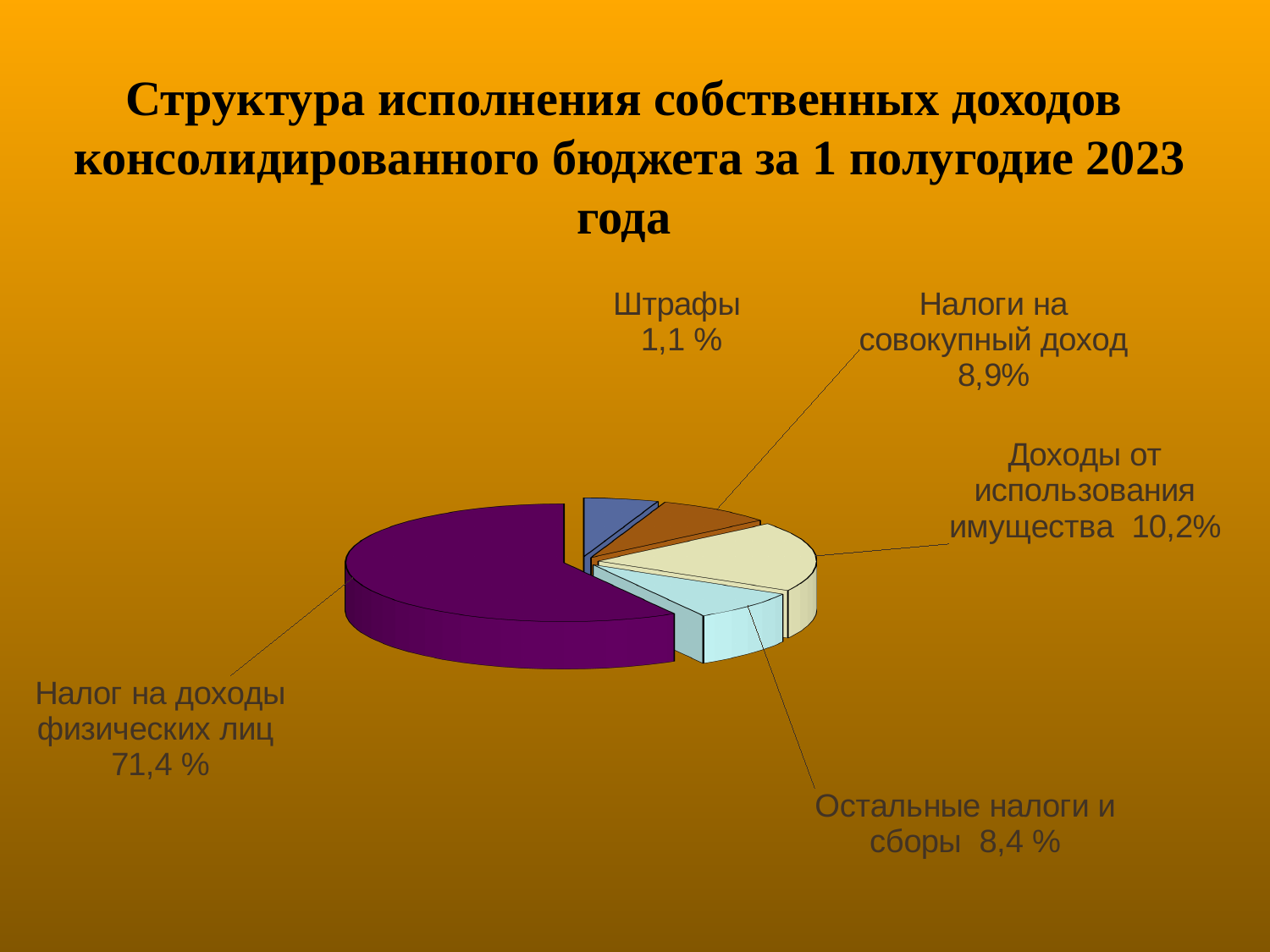
What value is shown for Налоги на совокупный доход? 8,9% How many slices does the pie chart have? 5 What is the title of the chart on the slide? Структура исполнения собственных доходов консолидированного бюджета за 1 полугодие 2023 года What share of the pie is labelled for Налог на доходы физических лиц? 71,4 % Which is larger: Налоги на совокупный доход or Остальные налоги и сборы? Налоги на совокупный доход What value is shown for Остальные налоги и сборы? 8,4 % What value is shown for Доходы от использования имущества? 10,2% Which category has the largest share of the pie? Налог на доходы физических лиц What type of chart is shown on the slide? Pie chart What is the difference in percentage points between Доходы от использования имущества and Налоги на совокупный доход? 1,3 What value is shown for Штрафы? 1,1 % Which category has the smallest share of the pie? Штрафы